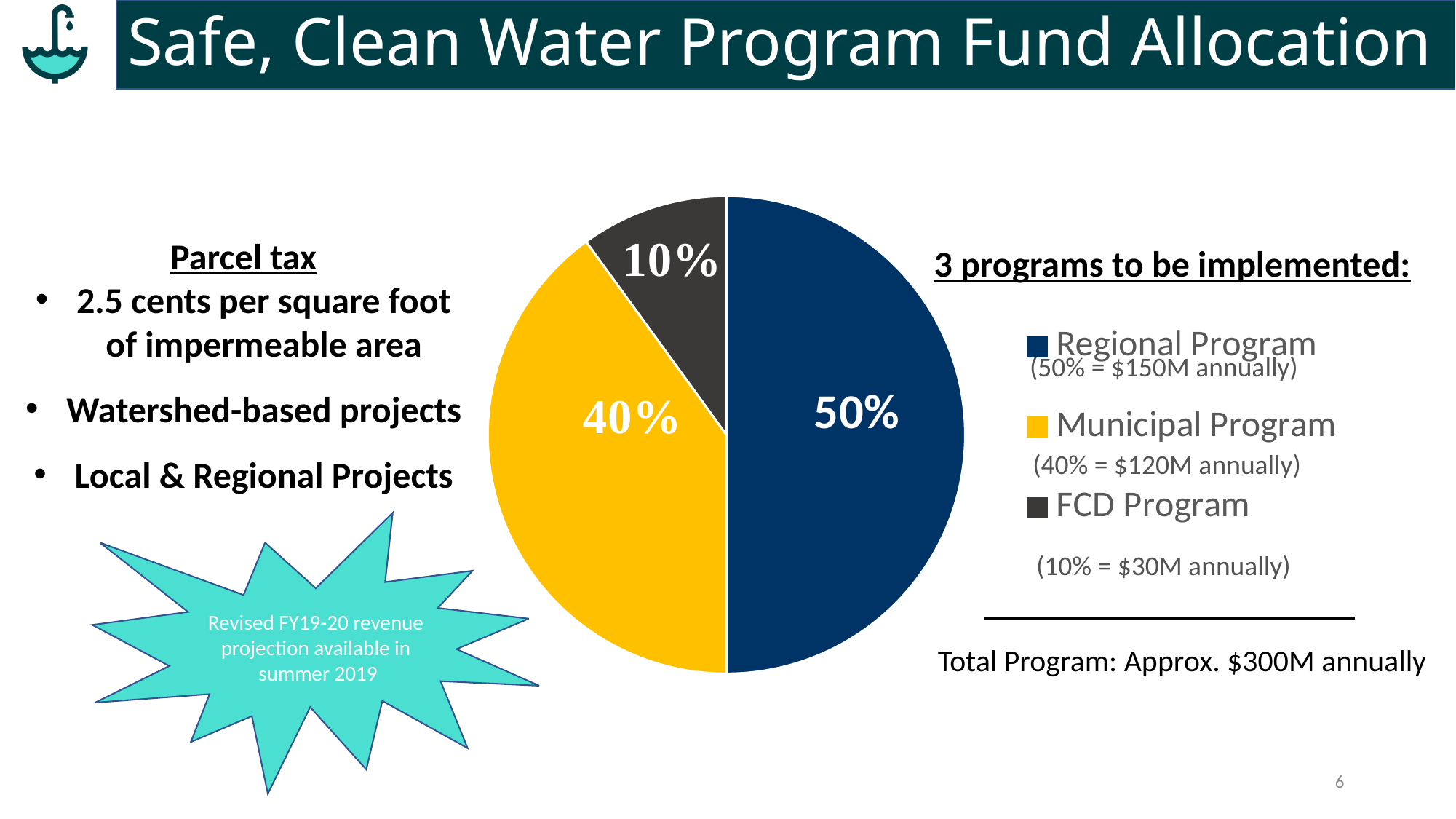
Which slice is larger, Municipal Program or FCD Program? Municipal Program How many entries does the legend list? 3 What is the difference in percentage points between the Municipal Program and the FCD Program slices? 30% What share of the pie does the Regional Program slice represent? 50% What is the difference in percentage points between the Regional Program and the Municipal Program slices? 10% What kind of chart is shown on the slide? pie chart What share of the pie does the Municipal Program slice represent? 40% What share of the pie does the FCD Program slice represent? 10% What colour is the Municipal Program slice? yellow Which program has the smallest slice of the pie? FCD Program Which program has the largest slice of the pie? Regional Program How many slices does the pie chart have? 3